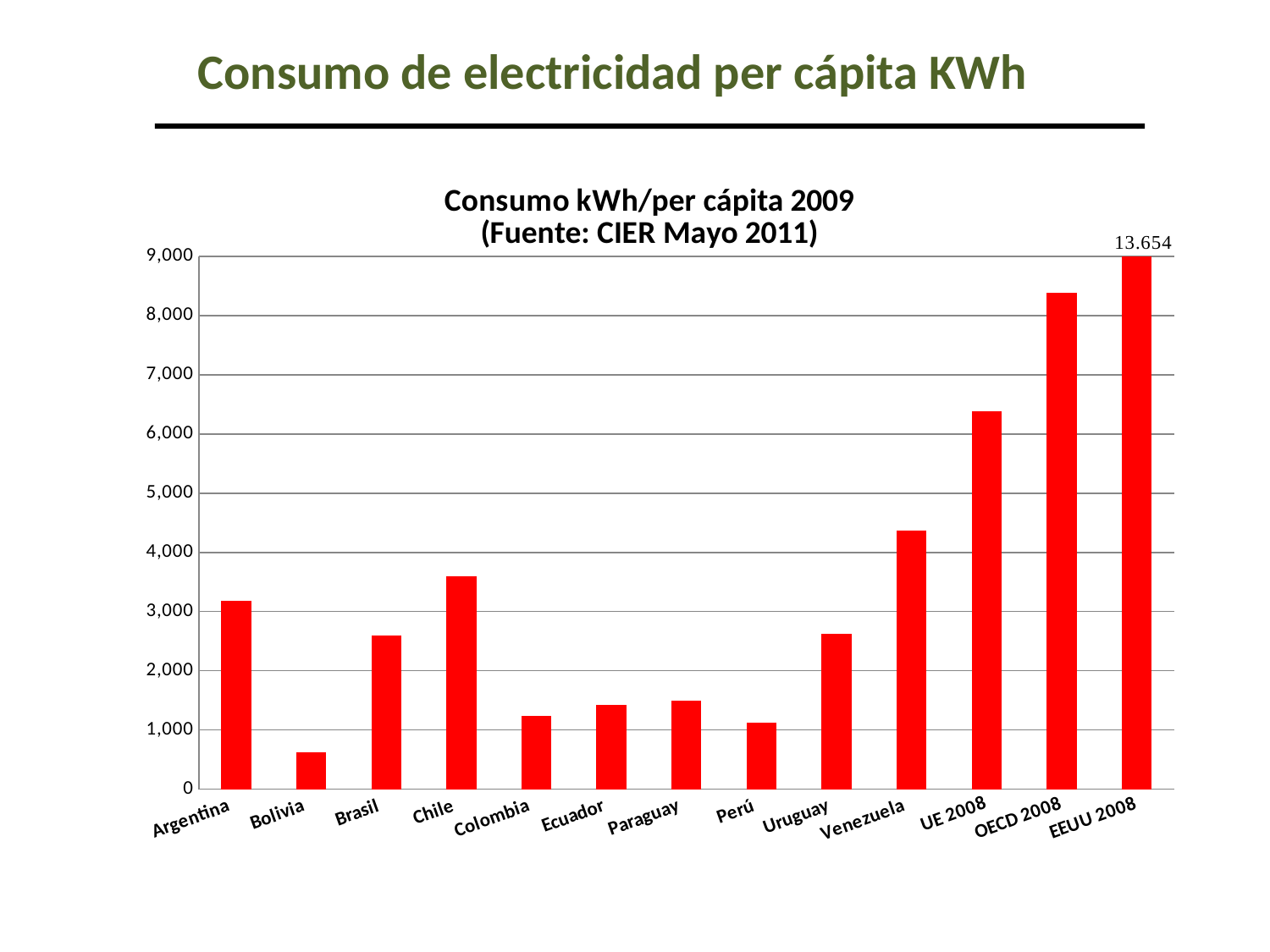
Is the value for Venezuela greater or less than 4,000? greater Which has a higher value, Venezuela or Uruguay? Venezuela What is the value shown for EEUU 2008? 13.654 Which has a higher value, Chile or Argentina? Chile Which category has the lowest electricity consumption per capita in the chart? Bolivia Is the value for Bolivia greater or less than 1,000? less Which category has the highest electricity consumption per capita in the chart? EEUU 2008 Is the value for Argentina greater or less than 3,000? greater What type of chart is shown on the slide? bar chart What is the title of the chart? Consumo kWh/per cápita 2009 (Fuente: CIER Mayo 2011) How many categories are shown on the x axis of the chart? 13